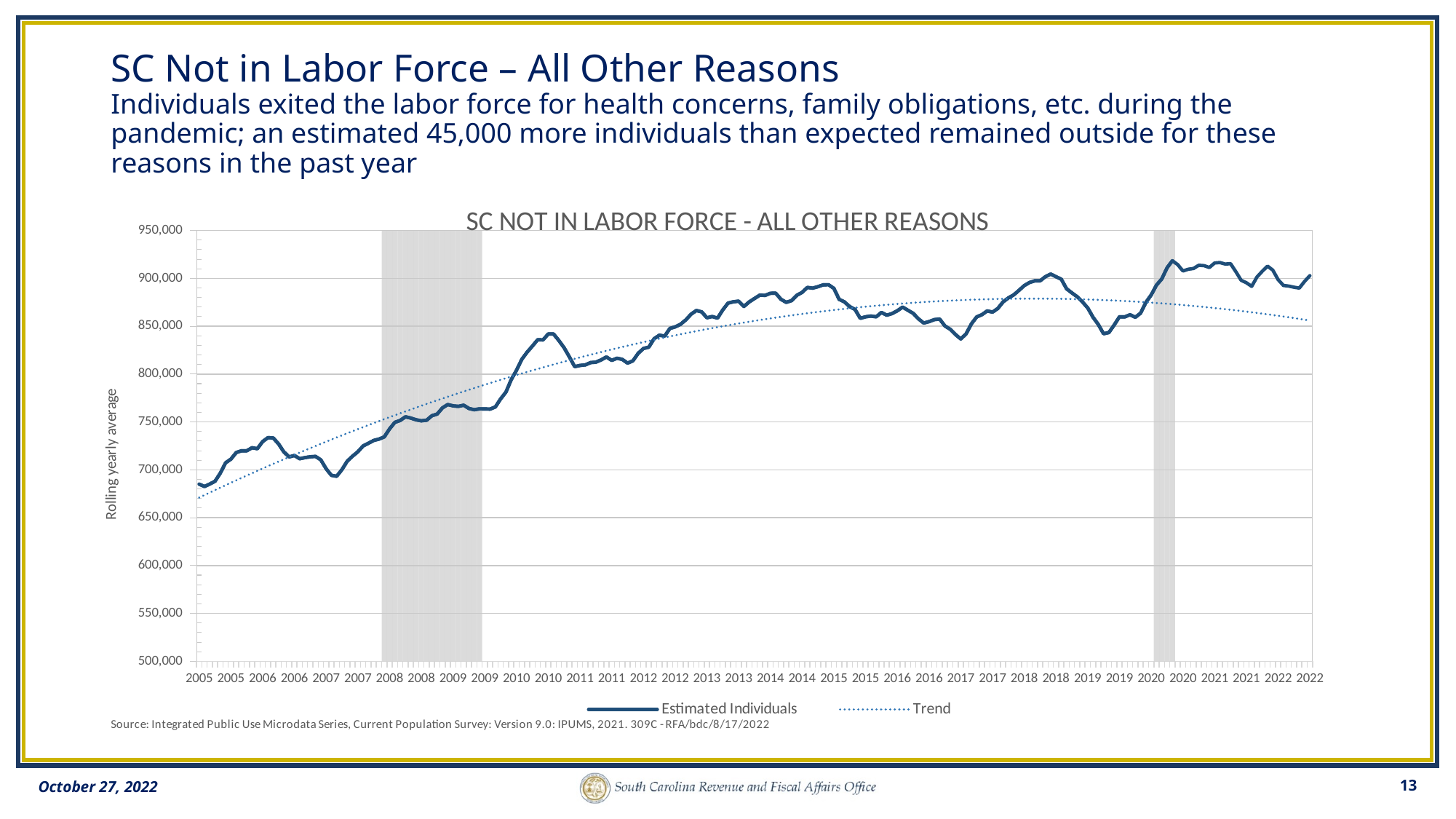
Is the Estimated Individuals value at the start of 2005 greater or less than 700,000? less Is the Estimated Individuals value at its 2015 peak greater or less than 900,000? less Which series is higher at the 2020 peak, Estimated Individuals or Trend? Estimated Individuals What is the title of the chart? SC NOT IN LABOR FORCE - ALL OTHER REASONS Is the Estimated Individuals value at its 2020 peak greater or less than 900,000? greater Overall, do the Estimated Individuals values rise or fall from 2005 to 2022? Rise What kind of chart is shown on the slide? Line chart What are the two series named in the chart legend? Estimated Individuals and Trend How many series does the chart legend list? 2